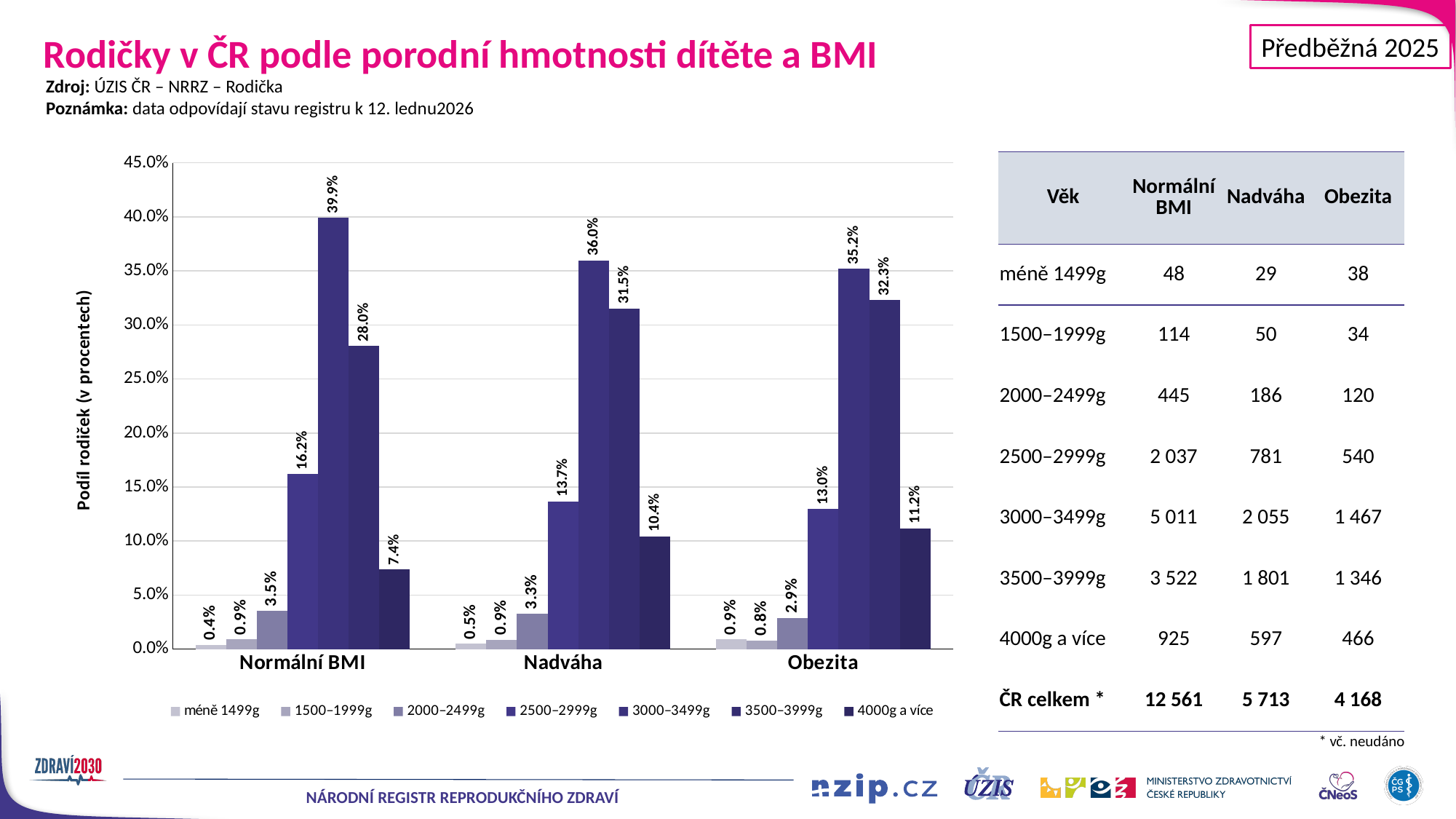
How many series does the chart legend list? 7 What is the value for the 2000–2499g series in the Nadváha category? 3.3% What is the difference between the 3000–3499g values for Normální BMI and Nadváha? 3.9 percentage points What is the value for the 4000g a více series in the Obezita category? 11.2% Is the value for the 3500–3999g series in the Nadváha category greater or less than 30.0%? greater How many BMI categories are shown on the x axis of the chart? 3 Which BMI category has the highest value for the 3500–3999g series? Obezita Which BMI category has the lowest value for the 4000g a více series? Normální BMI What is the value for the 3000–3499g series in the Normální BMI category? 39.9% What is the title of the chart's vertical axis? Podíl rodiček (v procentech) For the 2500–2999g series, which is larger: Nadváha or Obezita? Nadváha What kind of chart is shown on the slide? bar chart